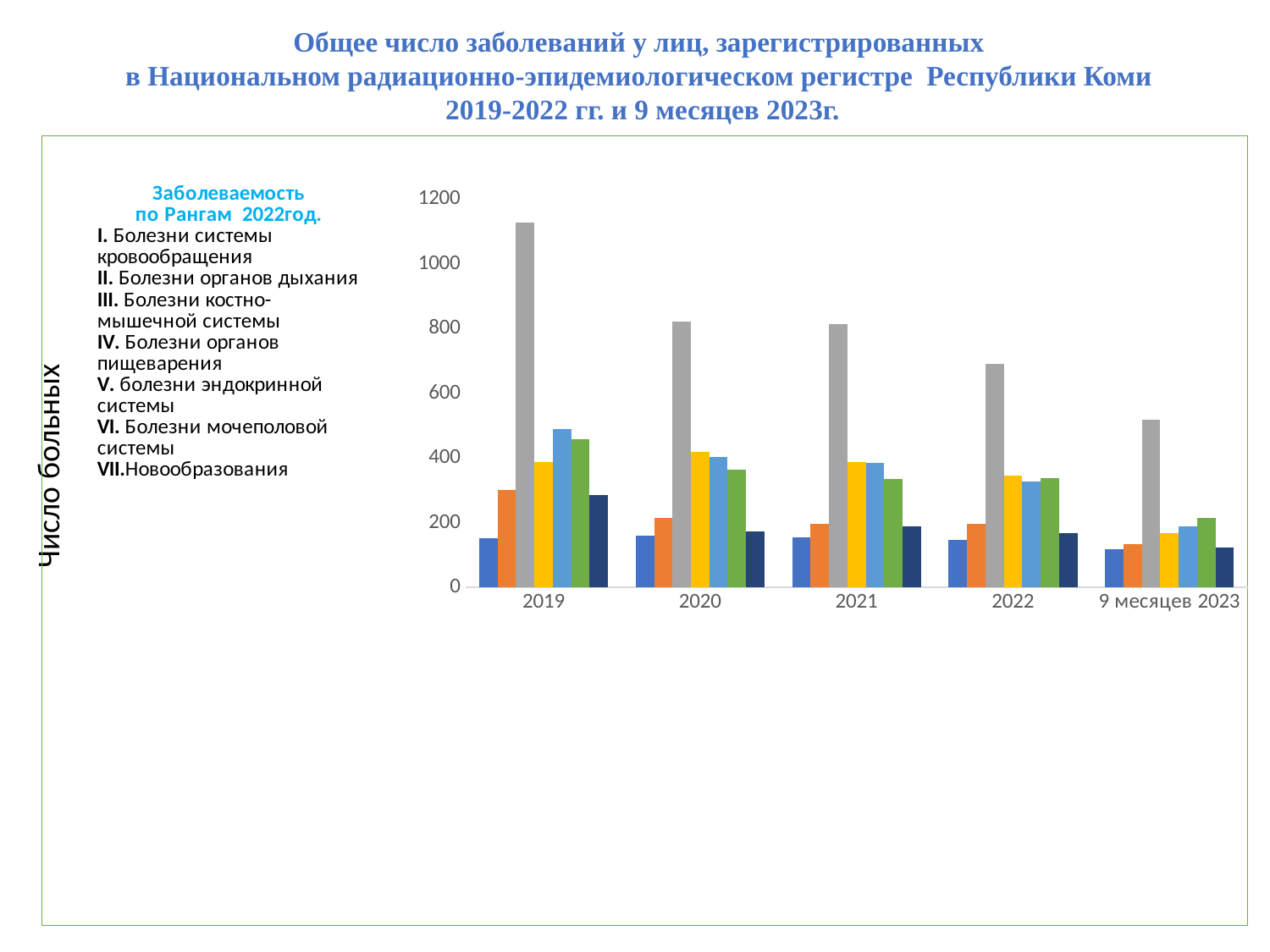
What is the label on the vertical axis of the chart? Число больных Do the gray bars rise or fall from 2019 to 9 месяцев 2023? fall In 2019, which is taller: the light blue bar or the yellow bar? the light blue bar Is the value of the gray bar for 9 месяцев 2023 greater or less than 600? less In which category is the gray bar the tallest? 2019 How many categories are shown along the x axis? 5 What kind of chart is shown on the slide? bar chart Is the value of the orange bar for 2019 greater or less than 200? greater Is the value of the gray bar for 2022 greater or less than 600? greater How many bars are plotted for each year group? 7